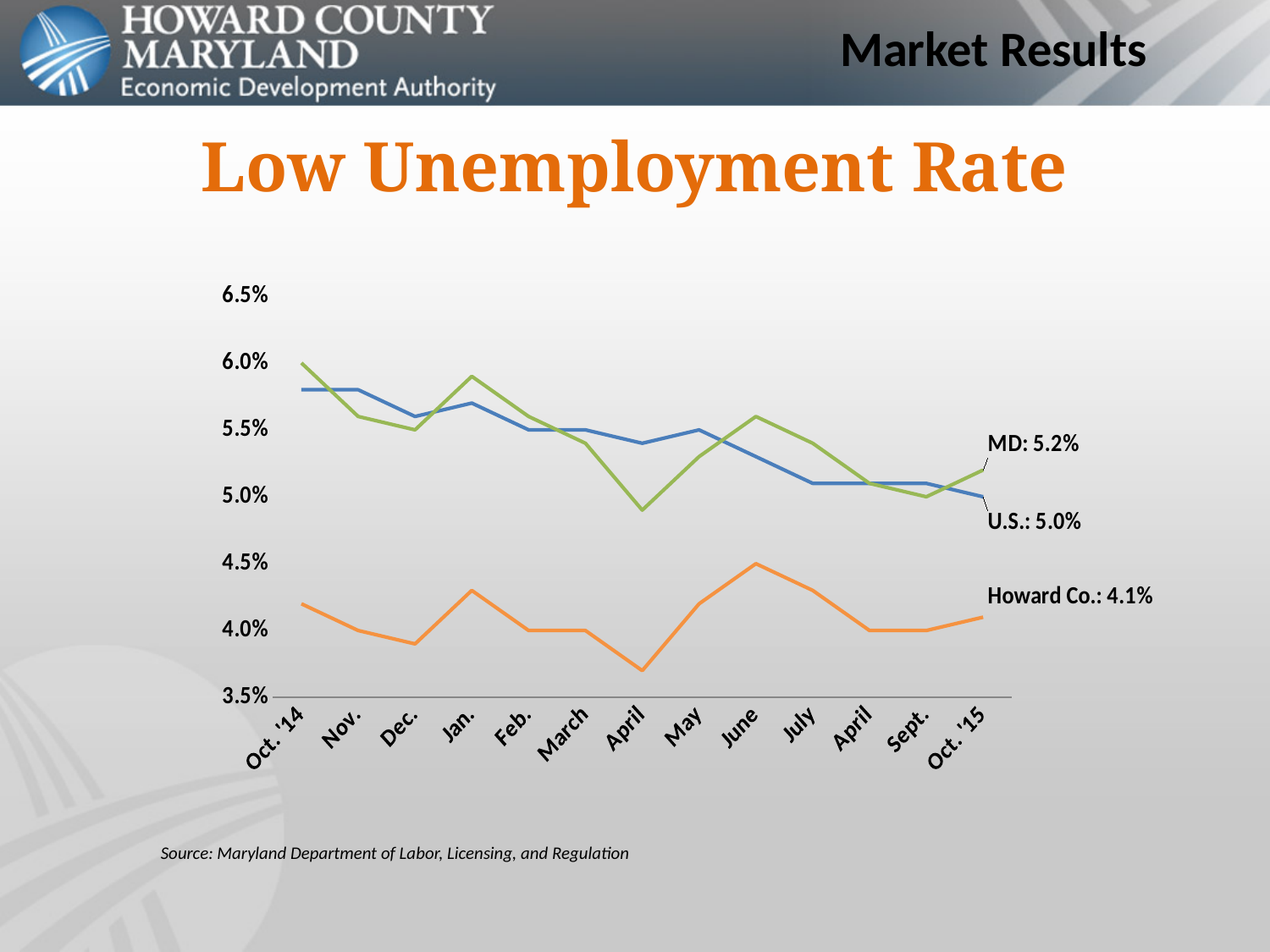
Which series has the lowest unemployment rate across the whole period? Howard Co. Does the U.S. line generally rise or fall from Oct. '14 to Oct. '15? fall By how many percentage points does the MD rate exceed the Howard Co. rate in Oct. '15? 1.1 In Oct. '15, which is higher, the MD rate or the U.S. rate? MD How many months are shown along the x axis? 13 What is the U.S. unemployment rate for Oct. '15? 5.0% What is the MD unemployment rate for Oct. '15? 5.2% What is the Howard Co. unemployment rate for Oct. '15? 4.1% What kind of chart is shown on the slide? line chart Is the MD value for Oct. '14 greater or less than 5.5%? greater How many series are plotted on the chart? 3